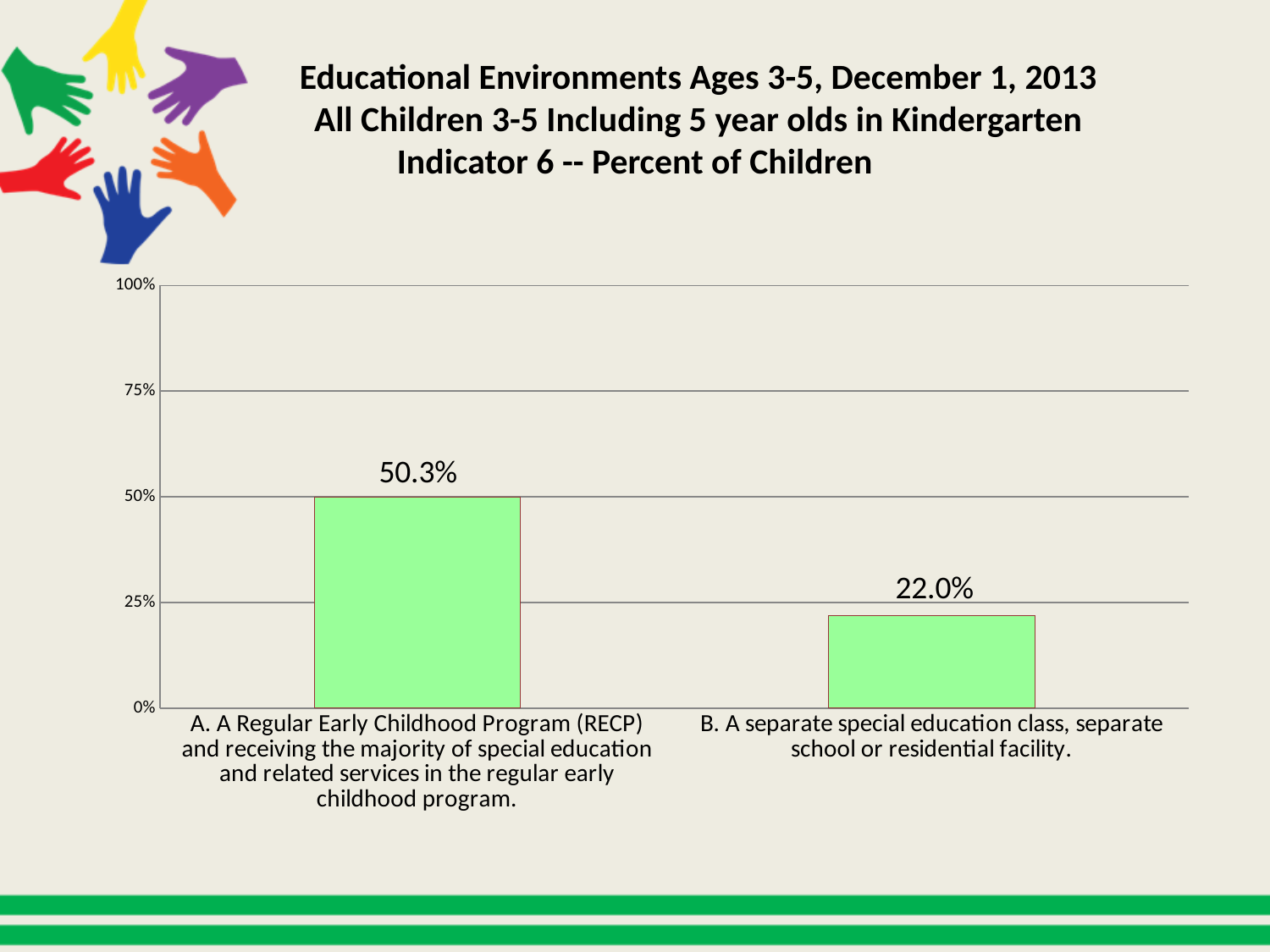
Which category has the highest value? A. A Regular Early Childhood Program (RECP) and receiving the majority of special education and related services in the regular early childhood program. Which is larger, the value for category A or the value for category B? Category A Which category has the lowest value? B. A separate special education class, separate school or residential facility. What is the value for category B (A separate special education class, separate school or residential facility)? 22.0% What is the value for category A (A Regular Early Childhood Program (RECP) and receiving the majority of special education and related services in the regular early childhood program)? 50.3% How many categories are shown in the chart? 2 What is the highest value shown on the vertical axis? 100% What colour are the bars in the chart? Light green What is the difference between the values for category A and category B? 28.3% Is the value for category B greater or less than 25%? less What kind of chart is shown on the slide? Bar chart Is the value for category A greater or less than 50%? greater